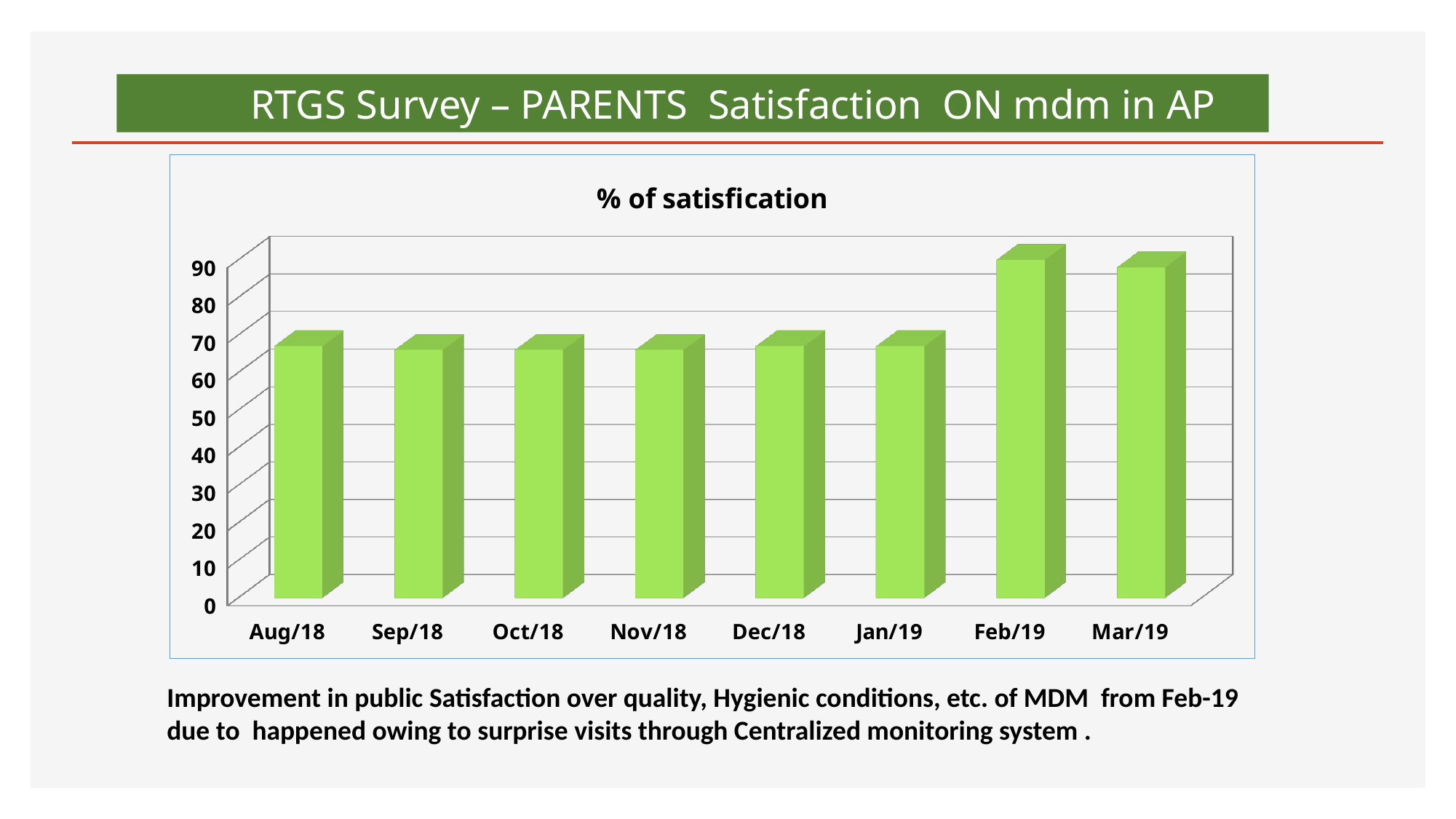
Which month has the highest % of satisfaction? Feb/19 How many months are shown on the x axis of the chart? 8 Which is larger, the value for Feb/19 or the value for Jan/19? Feb/19 What is the title of the chart? % of satisfication Is the value for Feb/19 greater or less than 80? greater Is the value for Sep/18 greater or less than 70? less Is the value for Jan/19 greater or less than 80? less Do the values rise or fall from Jan/19 to Feb/19? rise Which is larger, the value for Mar/19 or the value for Dec/18? Mar/19 What kind of chart is shown on the slide? bar chart